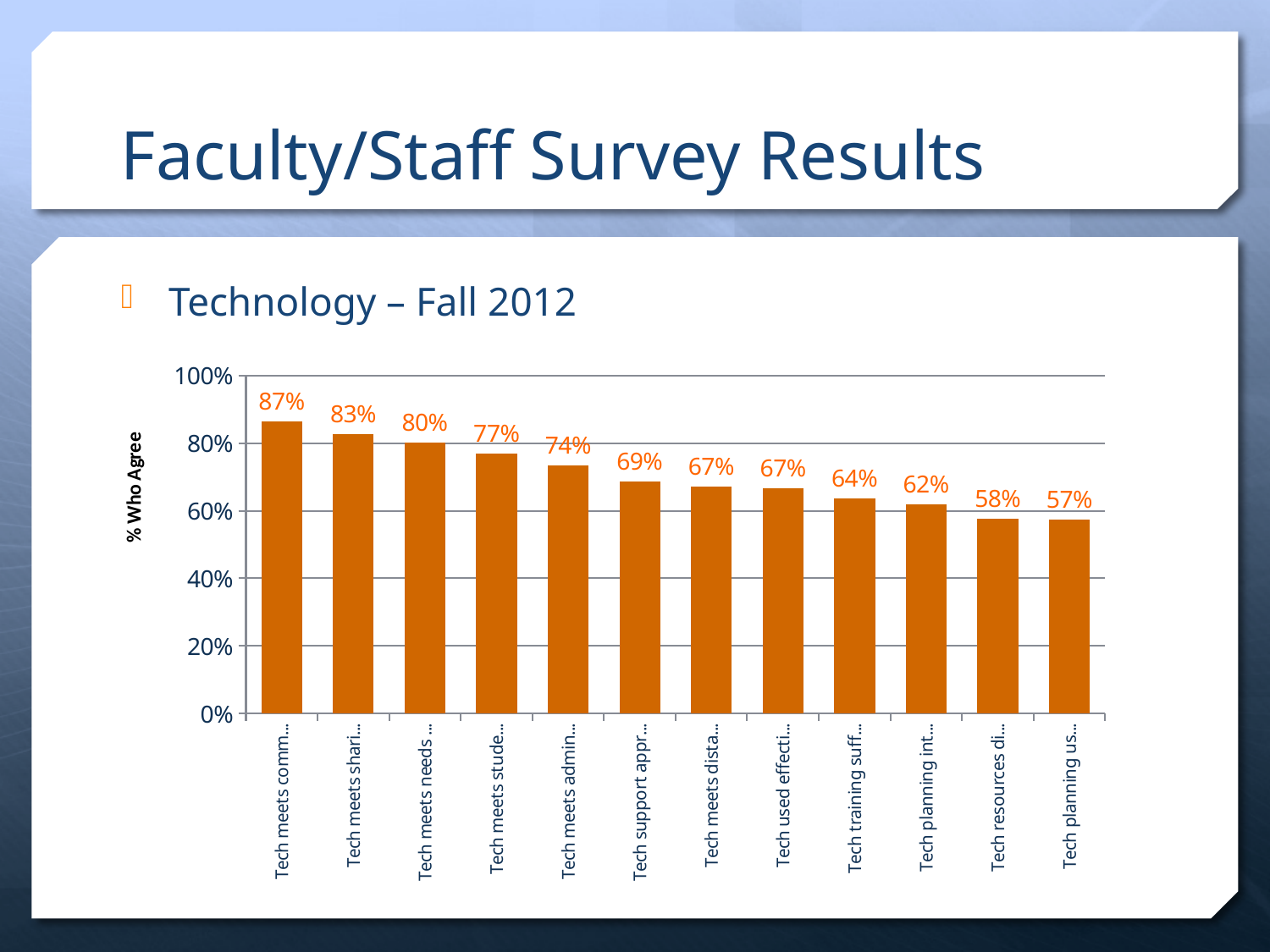
What type of chart is shown on the slide? Bar chart What is the value of the bar labelled "Tech support appr…"? 69% Do the bar values rise or fall from left to right across the chart? Fall Which bar has the highest value? Tech meets comm… (87%) What is the difference between the highest bar (87%) and the lowest bar (57%)? 30% What is the label on the vertical axis of the chart? % Who Agree Which is larger, the value for "Tech meets needs …" or the value for "Tech meets admin…"? Tech meets needs … (80%) How many bars are plotted in the chart? 12 Which bar has the lowest value? Tech planning us… (57%) What is the value of the bar labelled "Tech training suff…"? 64% What is the value of the last (rightmost) bar, labelled "Tech planning us…"? 57% What is the value of the first (leftmost) bar, labelled "Tech meets comm…"? 87%